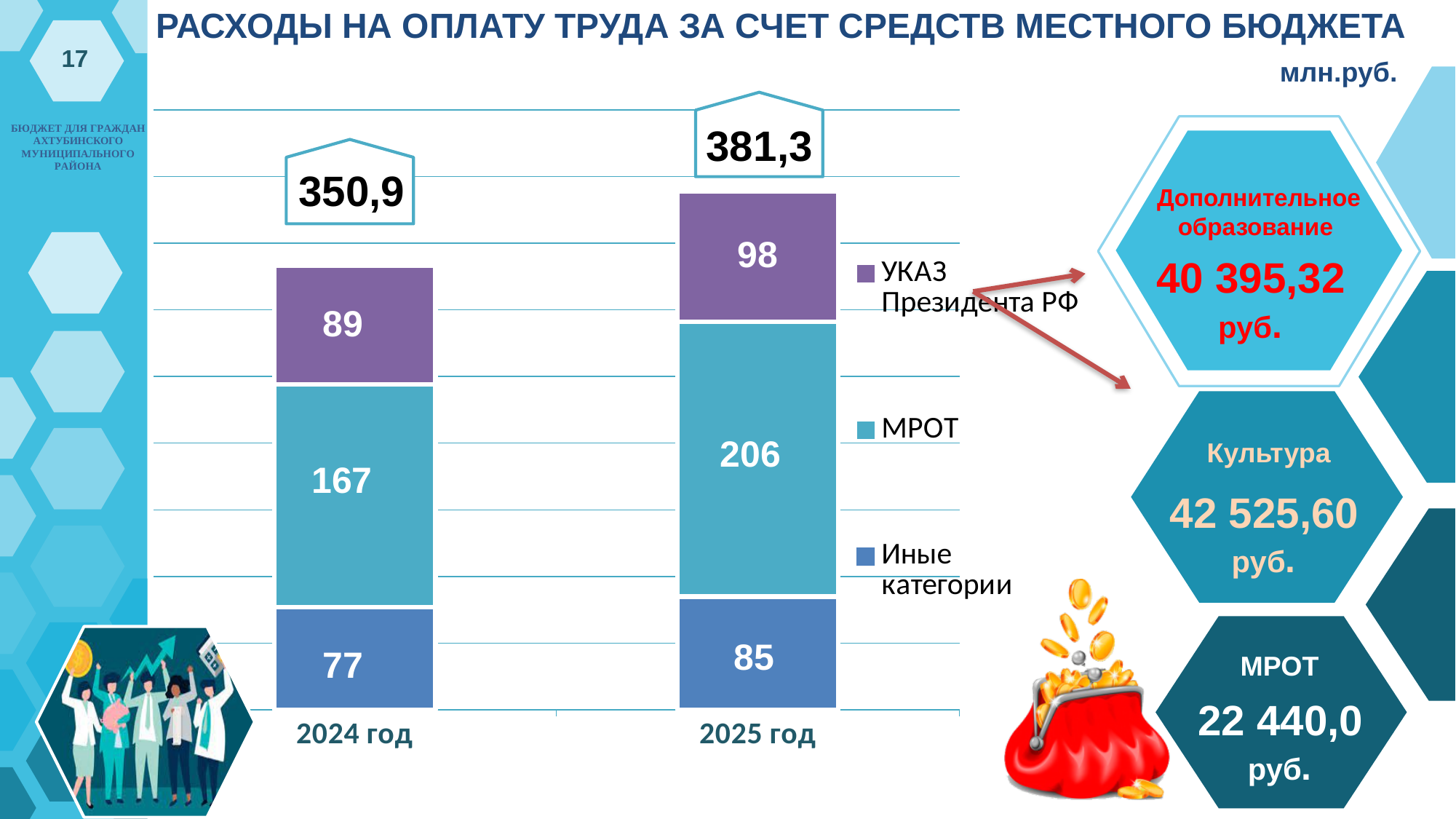
What total is printed above the bar for 2024 год? 350,9 What is the value of the Иные категории segment for 2024 год? 77 By how much does the МРОТ segment for 2025 год exceed the МРОТ segment for 2024 год? 39 What total is printed above the bar for 2025 год? 381,3 What kind of chart is shown on the slide? Stacked bar chart What is the value of the МРОТ segment for 2024 год? 167 Which year has the larger Иные категории segment, 2024 год or 2025 год? 2025 год Which series has the largest segment in the 2025 год bar? МРОТ Which series is shown in purple in the chart legend? УКАЗ Президента РФ How many years (categories) are shown on the x axis of the chart? 2 What is the value of the УКАЗ Президента РФ segment for 2025 год? 98 How many series does the chart legend list? 3